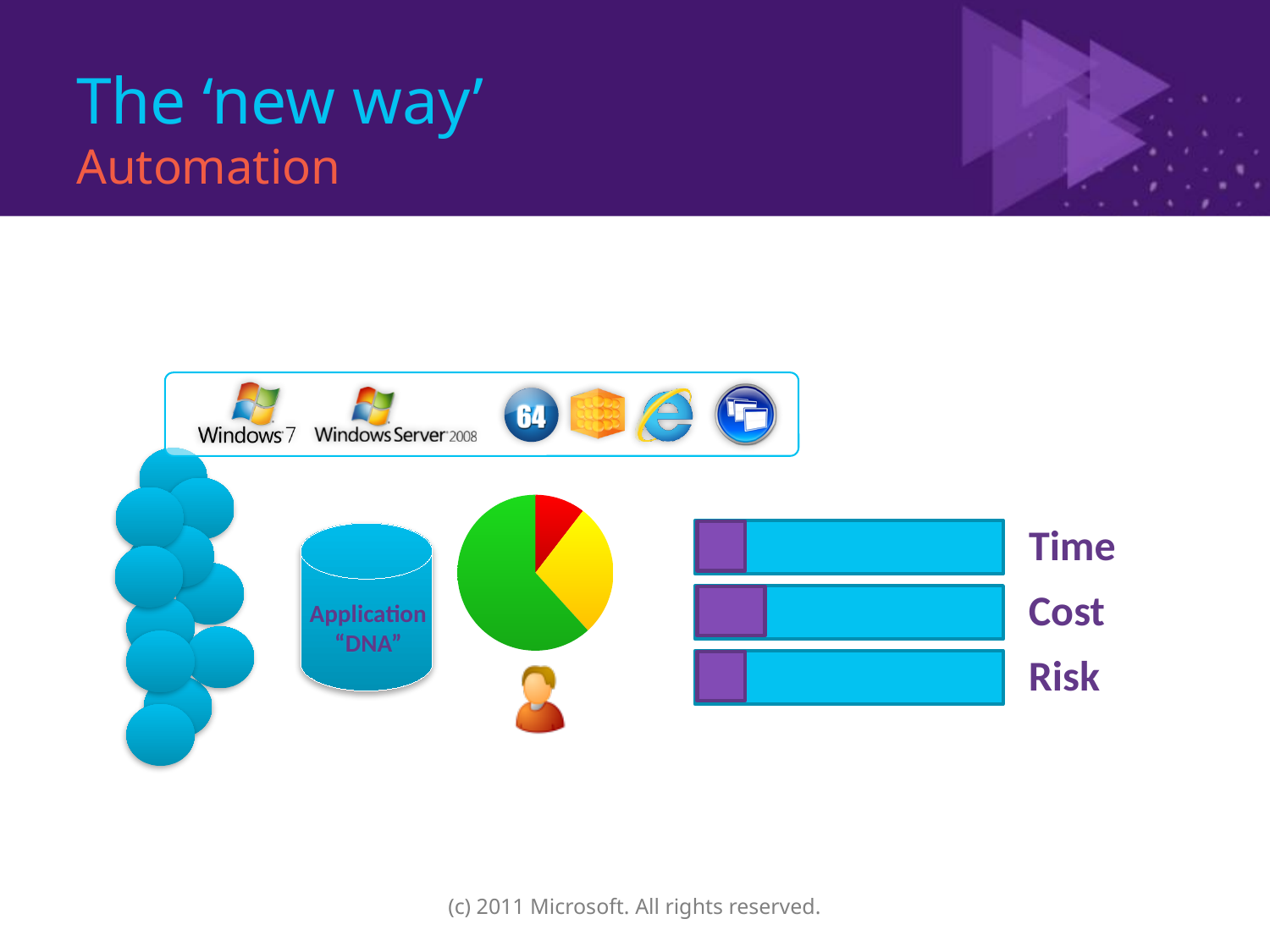
How many horizontal bars are shown on the right side of the slide? 3 How many slices does the pie chart have? 3 What kind of chart is shown in the middle of the slide, next to the 'Application DNA' cylinder? pie chart Which colour slice of the pie chart is the largest? green Which of the three horizontal bars on the right has the longest purple portion? Cost Which colour slice of the pie chart is the smallest? red What are the labels next to the three horizontal bars on the right of the slide? Time, Cost, Risk